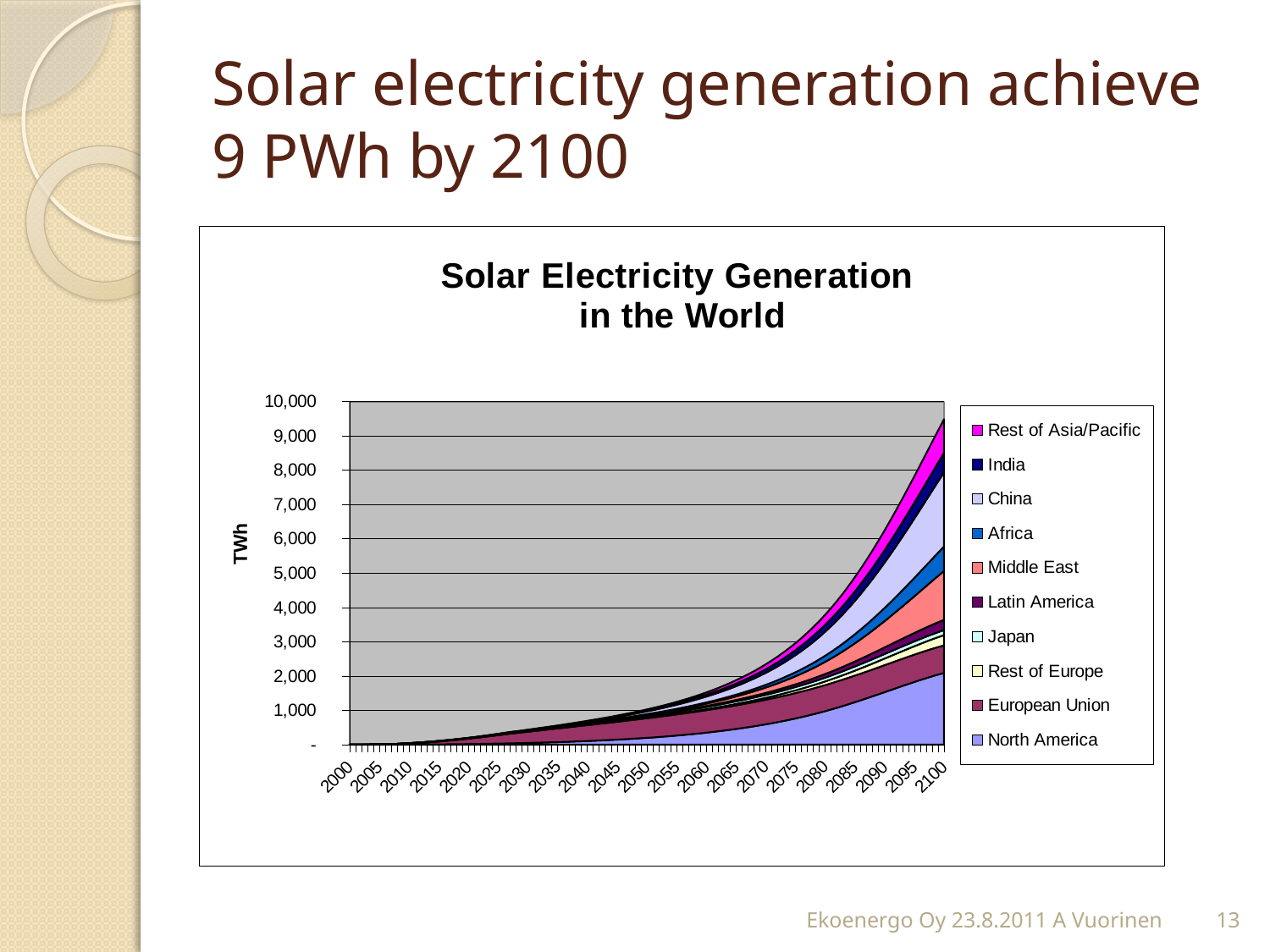
What kind of chart is shown on the slide? Stacked area chart Is the total solar electricity generation in 2050 greater or less than 2,000 TWh? less Does total solar electricity generation rise or fall from 2000 to 2100? Rises How many series does the chart legend list? 10 In 2100, which region has the larger solar electricity generation, China or India? China How many year labels are shown on the x axis? 21 What is the title of the chart? Solar Electricity Generation in the World Is the total solar electricity generation in 2100 greater or less than 9,000 TWh? greater In 2100, which region has the larger solar electricity generation, North America or European Union? North America Is the total solar electricity generation in 2025 greater or less than 1,000 TWh? less What unit is shown on the vertical axis label? TWh